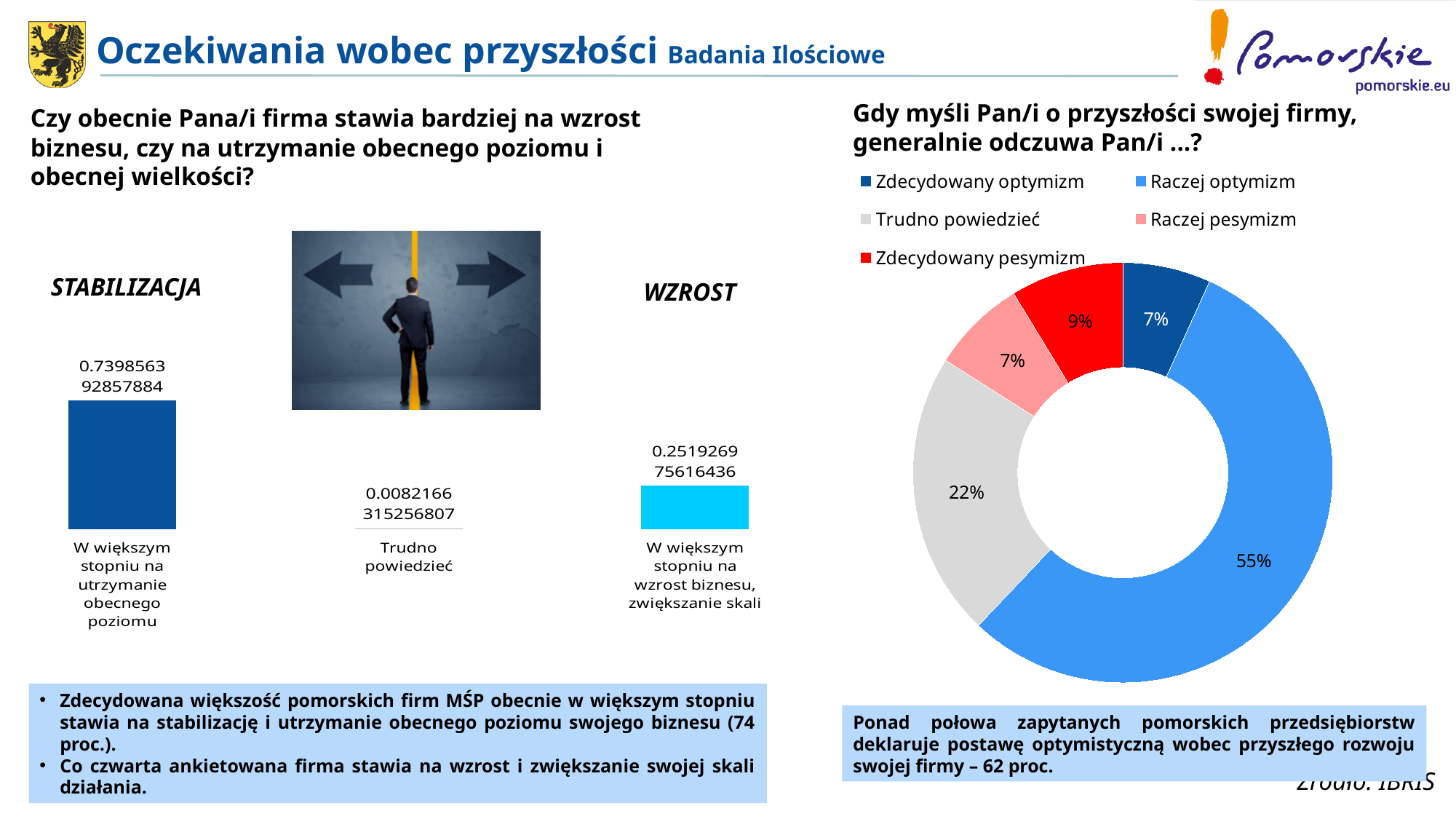
On the left chart, which is larger: the value for 'W większym stopniu na utrzymanie obecnego poziomu' or for 'W większym stopniu na wzrost biznesu, zwiększanie skali'? W większym stopniu na utrzymanie obecnego poziomu On the right chart (Gdy myśli Pan/i o przyszłości swojej firmy...), what kind of chart is shown? doughnut chart On the right chart, what share is shown for 'Raczej optymizm'? 55% On the right chart, what is the difference between the shares for 'Zdecydowany pesymizm' and 'Zdecydowany optymizm'? 2% On the left chart, which category has the highest value? W większym stopniu na utrzymanie obecnego poziomu On the left chart, what is the value printed for 'Trudno powiedzieć'? 0.0082166315256807 On the left chart, which category has the lowest value? Trudno powiedzieć On the right chart, what share is shown for 'Trudno powiedzieć'? 22% On the right chart, how many entries does the legend list? 5 On the left chart (Czy obecnie Pana/i firma stawia bardziej na wzrost biznesu...), what kind of chart is shown? bar chart On the left chart, what is the value printed for 'W większym stopniu na wzrost biznesu, zwiększanie skali'? 0.251926975616436 On the left chart, how many bars are plotted? 3